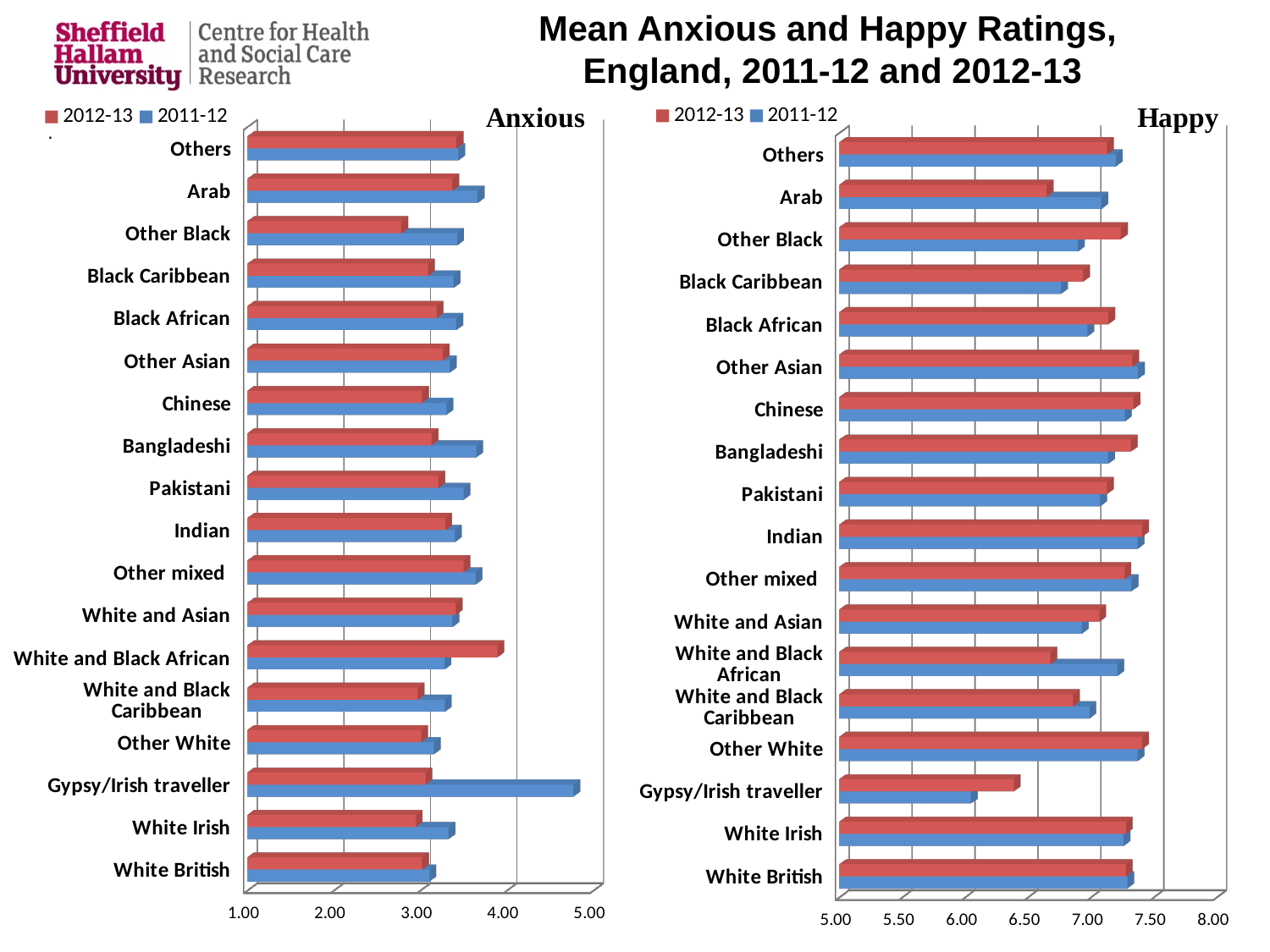
What kind of chart is the Anxious chart on the left of the slide? Bar chart On the Anxious chart, which category has the highest 2012-13 value? White and Black African On the Happy chart, which category has the lowest 2011-12 value? Gypsy/Irish traveller On the Anxious chart, which category has the highest 2011-12 value? Gypsy/Irish traveller How many series does the legend of the Happy chart list? 2 On the Happy chart, for Other Black, which series has the larger value, 2012-13 or 2011-12? 2012-13 On the Happy chart, is the 2012-13 value for Arab greater or less than 7.00? less On the Anxious chart, for Gypsy/Irish traveller, which series has the larger value, 2012-13 or 2011-12? 2011-12 On the Anxious chart, is the 2011-12 value for Gypsy/Irish traveller greater or less than 4.00? greater On the Happy chart, which category has the lowest 2012-13 value? Gypsy/Irish traveller How many ethnic group categories are shown on the Anxious chart? 18 What colour represents the 2012-13 series in the legends of both charts? Red